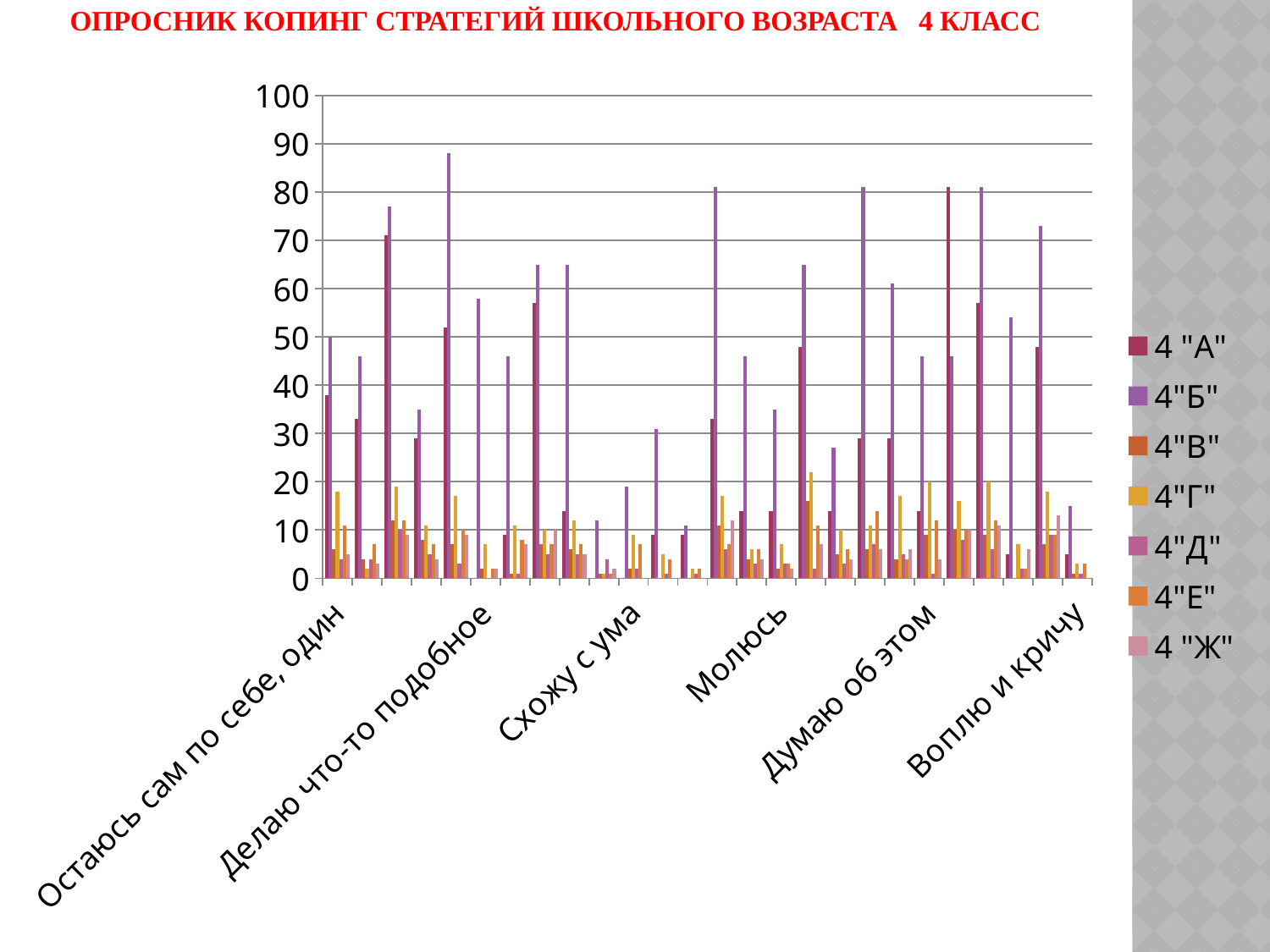
Is the tallest bar on the chart greater or less than 90? less How many series does the legend list? 7 Which series is listed first in the legend? 4 "А" What is the title of the slide? ОПРОСНИК КОПИНГ СТРАТЕГИЙ ШКОЛЬНОГО ВОЗРАСТА 4 КЛАСС Which series has the tallest bar on the chart? 4"Б" Is the tallest bar on the chart greater or less than 80? greater What kind of chart is shown on the slide? bar chart